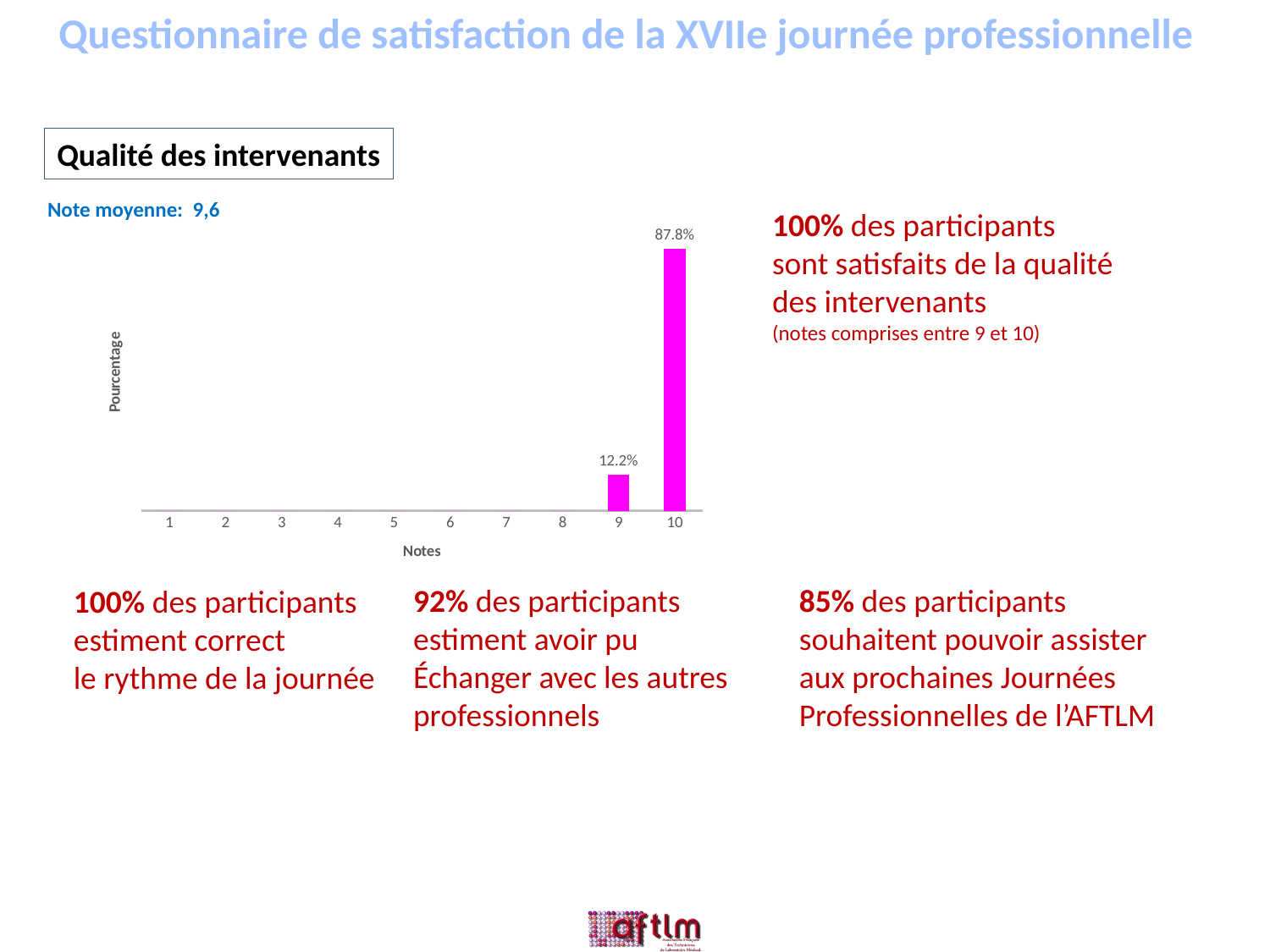
What is the label of the y axis of the chart? Pourcentage How many notes have a visible bar in the chart? 2 What percentage of participants gave a note of 10? 87.8% What is the total percentage for notes 9 and 10 combined? 100% Which note has the larger percentage, 9 or 10? 10 Which note received the highest percentage? 10 Do the percentages rise or fall from note 9 to note 10? rise What percentage of participants gave a note of 9? 12.2% What kind of chart is shown on the slide? bar chart What is the label of the x axis of the chart? Notes How many notes are shown on the x axis of the chart? 10 What is the difference between the percentage for note 10 and the percentage for note 9? 75.6%